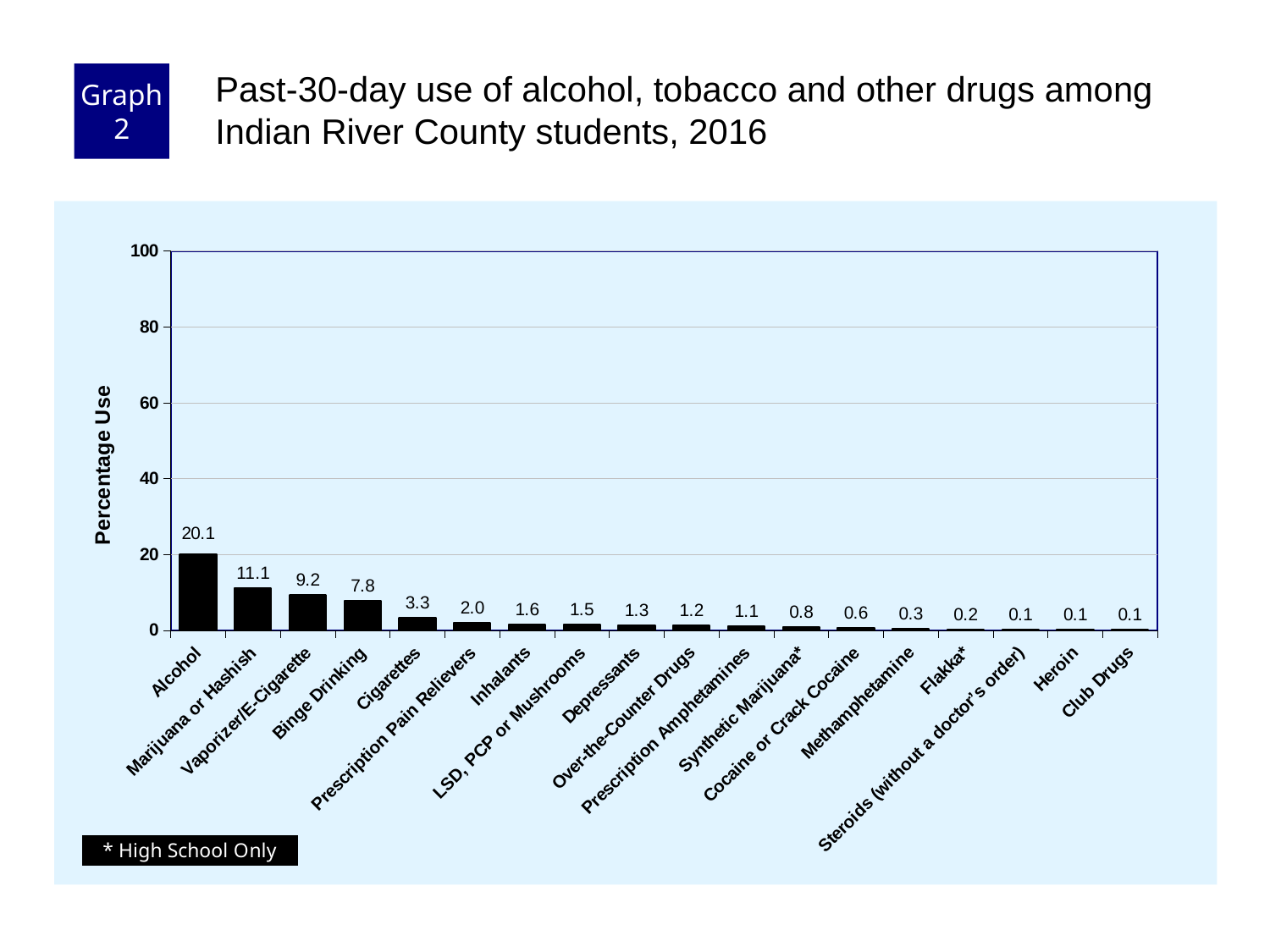
What is the difference between the values for Alcohol and Binge Drinking? 12.3 What value is shown for Marijuana or Hashish? 11.1 Is the value for Alcohol greater or less than 40? less Which is larger, the value for Inhalants or the value for Depressants? Inhalants What kind of chart is shown on the slide? Bar chart What is the label on the y axis? Percentage Use How many categories are shown on the x axis? 18 Which category has the highest percentage use? Alcohol What value is shown for Vaporizer/E-Cigarette? 9.2 What value is shown for Cigarettes? 3.3 What value is shown for Methamphetamine? 0.3 What is the past-30-day use percentage for Alcohol? 20.1